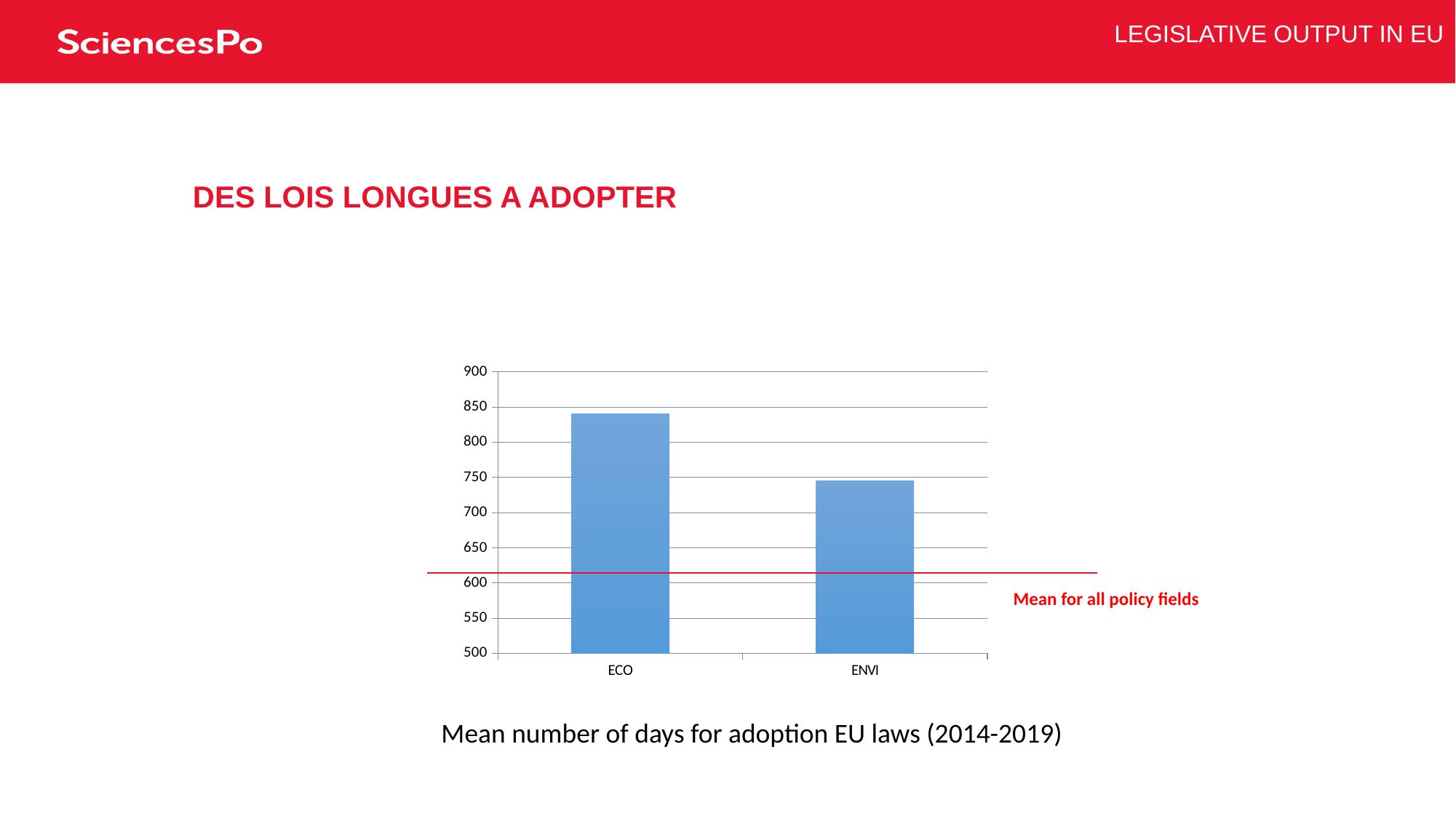
Which bar is taller, ECO or ENVI? ECO Which category has the lowest bar in the chart? ENVI What kind of chart is shown on the slide? bar chart Is the value for ECO greater or less than 800? greater Do the bar values rise or fall from ECO to ENVI along the x axis? fall How many categories are plotted on the x axis of the chart? 2 What does the red horizontal line on the chart represent, according to its label? Mean for all policy fields Is the value for ENVI greater or less than 800? less What is the caption printed below the chart? Mean number of days for adoption EU laws (2014-2019) Is the value for ENVI greater or less than 700? greater Which category has the highest bar in the chart? ECO